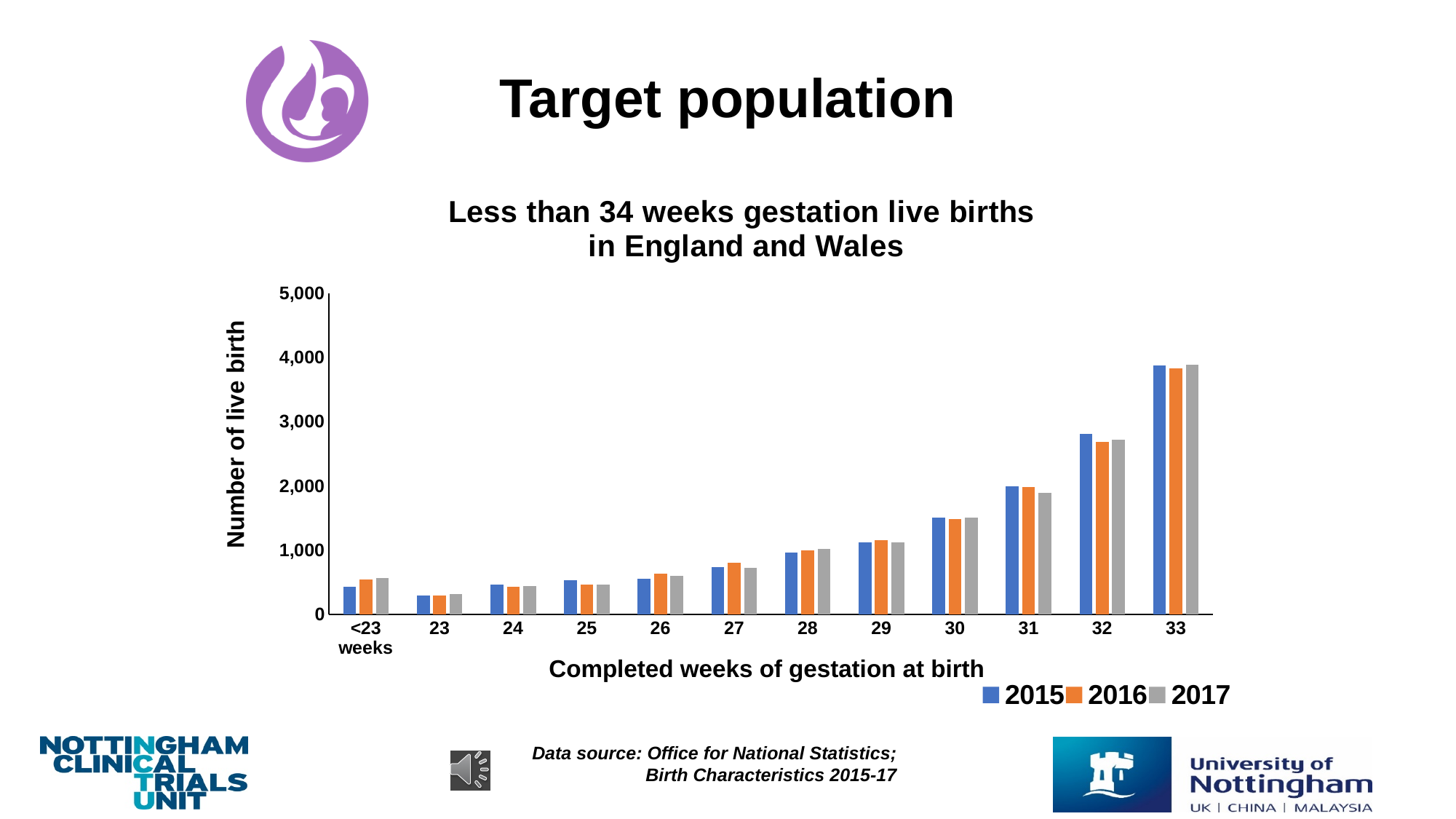
What is the label of the y axis? Number of live birth Is the value for 31 weeks in 2017 greater or less than 2,000? less How many series does the legend list? 3 From 23 weeks to 33 weeks, do the number of live births generally rise or fall along the x axis? rise Is the value for 32 weeks in 2017 greater or less than 2,000? greater Is the value for 23 weeks in 2016 greater or less than 1,000? less Which gestation category has the lowest number of live births for 2016? 23 Which is larger for 2017: the value for 23 weeks or the value for 24 weeks? 24 weeks How many gestation categories are shown on the x axis? 12 What kind of chart is shown on the slide? bar chart Which gestation category has the highest number of live births for 2015? 33